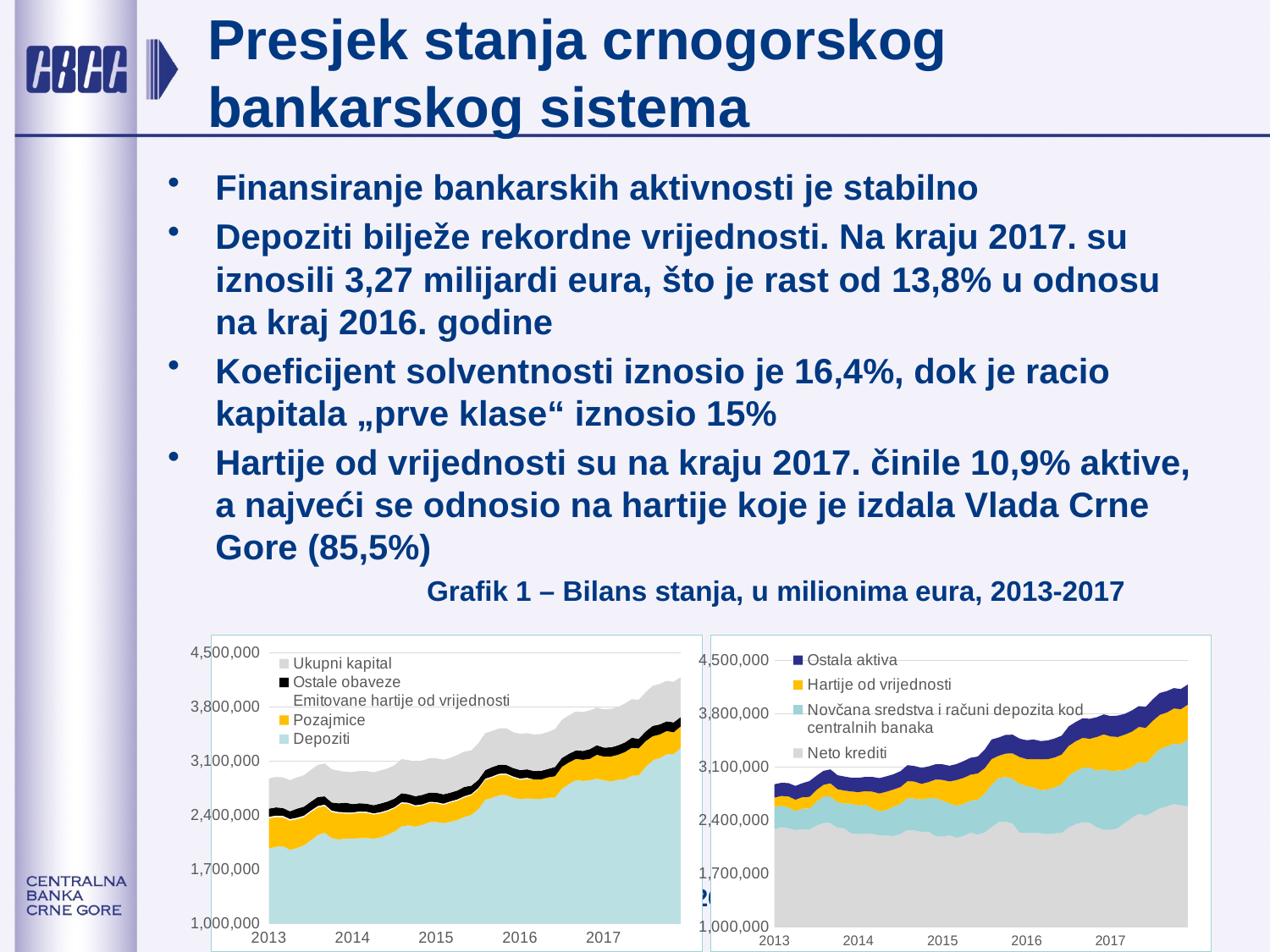
How many years are labelled on the x axis of the left chart? 5 In the left chart, does the Depoziti series rise or fall from 2013 to 2017? rise In the left chart, is the value for Depoziti at the end of 2017 greater or less than 3,100,000? greater In the right chart, is the value for Neto krediti at the end of 2017 greater or less than 2,400,000? greater In the right chart, is the total of all stacked series at the end of 2017 greater or less than 3,800,000? greater How many series does the legend of the left chart list? 5 In the left chart, which series is shown in yellow? Pozajmice What kind of chart is the left chart on the slide? stacked area chart How many series does the legend of the right chart list? 4 What kind of chart is the right chart on the slide? stacked area chart What is the title shown above the charts? Grafik 1 – Bilans stanja, u milionima eura, 2013-2017